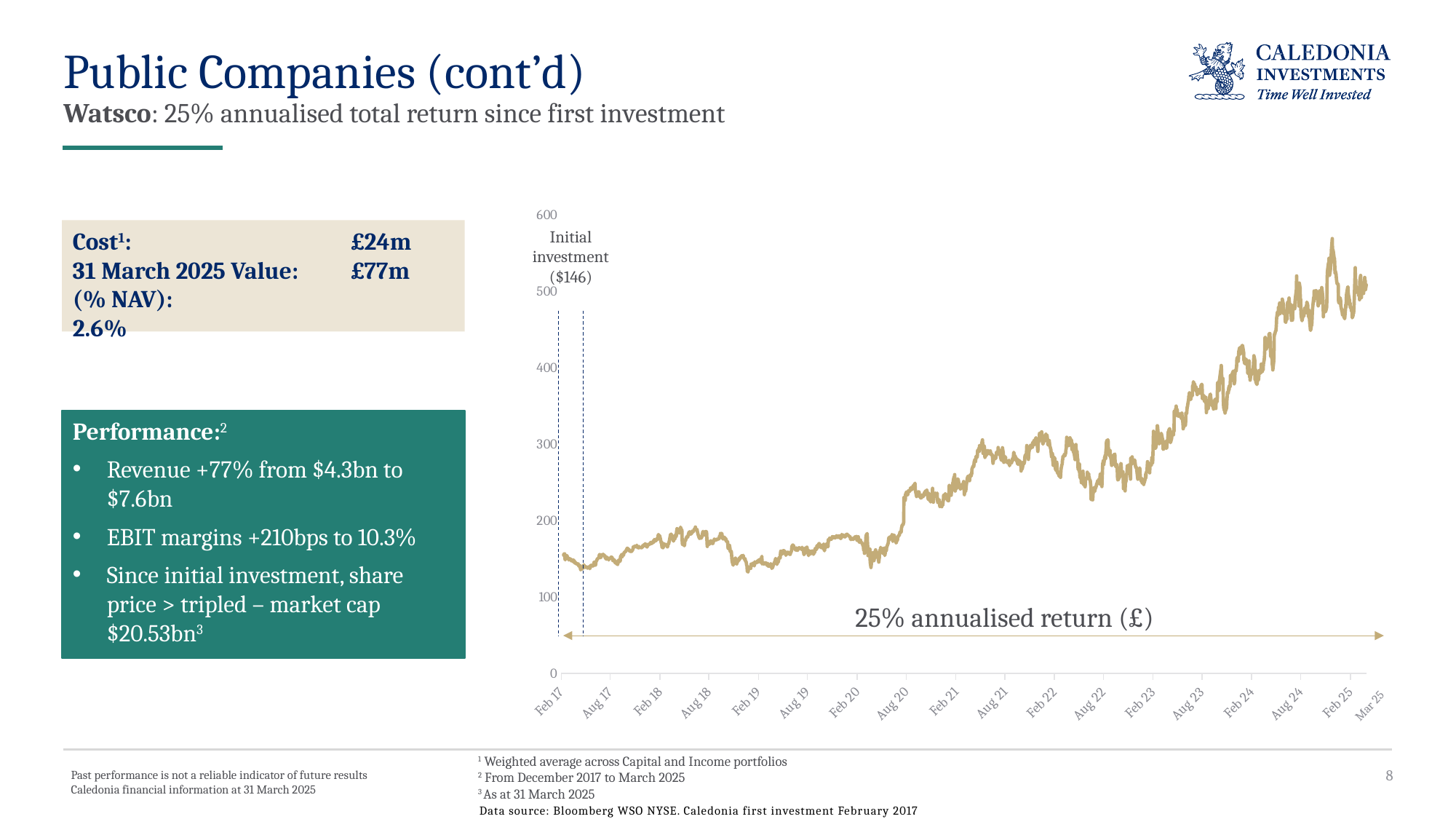
What annualised return is annotated on the chart? 25% annualised return (£) Is the value at Aug 24 greater or less than 400? greater What is the highest value shown on the chart's y axis? 600 Is the value at Aug 23 greater or less than 300? greater Does the share price line generally rise or fall from Feb 17 to Mar 25? rise Is the value at Feb 17 greater or less than 200? less Which is larger, the value at Aug 21 or the value at Aug 18? Aug 21 What kind of chart is shown on the slide? line chart Which is larger, the value at Feb 25 or the value at Feb 17? Feb 25 What share price is given for the initial investment on the chart? $146